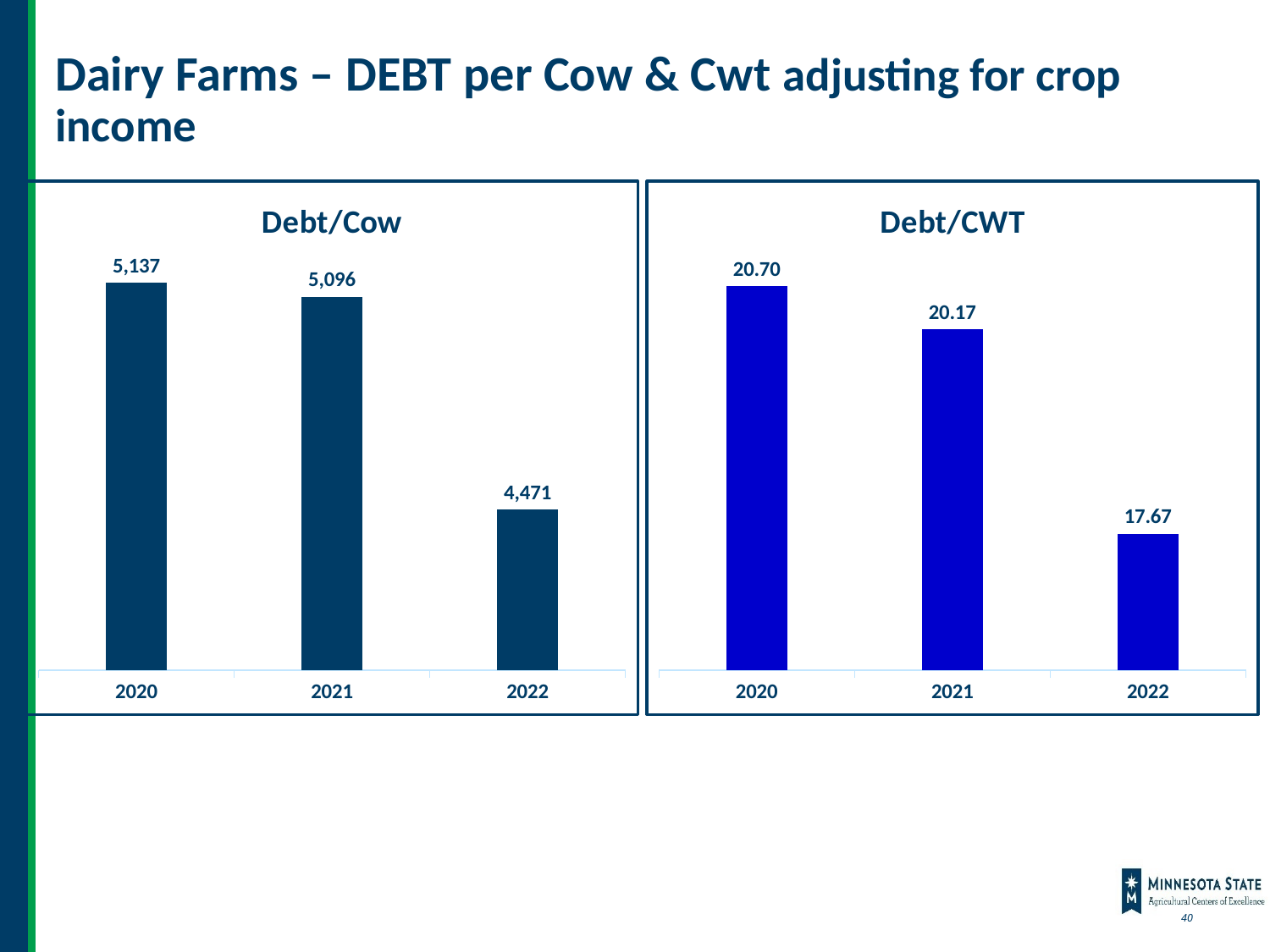
In the Debt/CWT chart, what is the value for 2021? 20.17 In the Debt/CWT chart, which is larger, the value for 2020 or the value for 2021? 2020 In the Debt/CWT chart, which year has the lowest value? 2022 In the Debt/Cow chart, what is the difference between the 2021 and 2022 values? 625 In the Debt/Cow chart, do the values rise or fall from 2020 to 2022? Fall In the Debt/Cow chart, what is the value for 2022? 4,471 In the Debt/Cow chart, what is the value for 2020? 5,137 In the Debt/CWT chart, what is the difference between the 2020 and 2022 values? 3.03 In the Debt/Cow chart, which year has the highest value? 2020 What kind of chart is the Debt/CWT chart? Bar chart In the Debt/CWT chart, what is the value for 2022? 17.67 How many years are shown in the Debt/Cow chart? 3